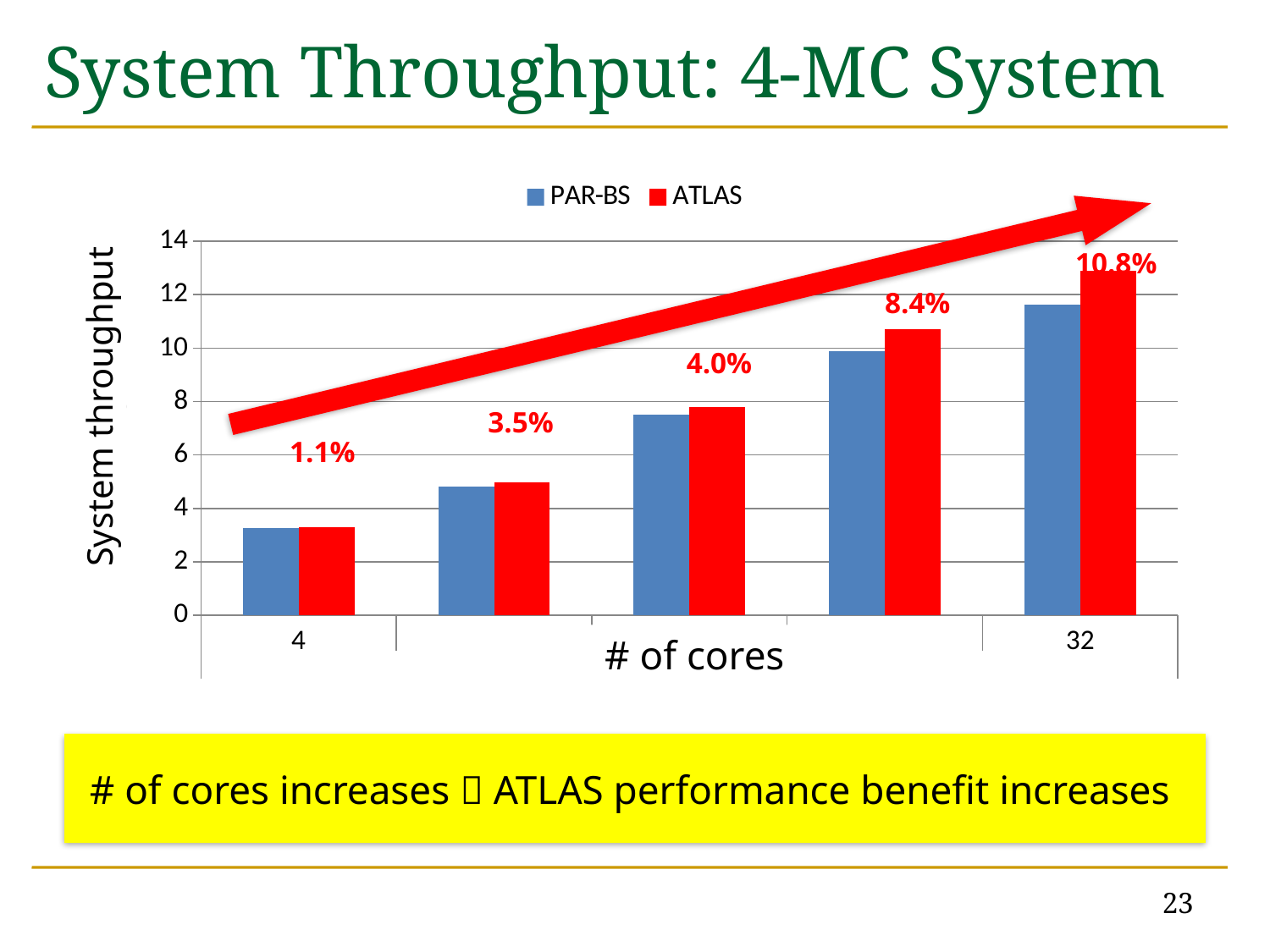
How many groups of bars (core counts) are plotted on the chart? 5 Do the system throughput values rise or fall as the number of cores increases along the x axis? rise Is the PAR-BS system throughput for 32 cores greater or less than 10? greater Which core count has the highest ATLAS system throughput? 32 What are the two series named in the legend? PAR-BS and ATLAS Is the ATLAS system throughput for 32 cores greater or less than 12? greater What is the percentage improvement label shown above the bars for 32 cores? 10.8% How many series does the legend list? 2 What kind of chart is shown on the slide? bar chart For 32 cores, which series has the higher system throughput, PAR-BS or ATLAS? ATLAS Is the PAR-BS system throughput for 4 cores greater or less than 4? less What is the percentage improvement label shown above the bars for 4 cores? 1.1%